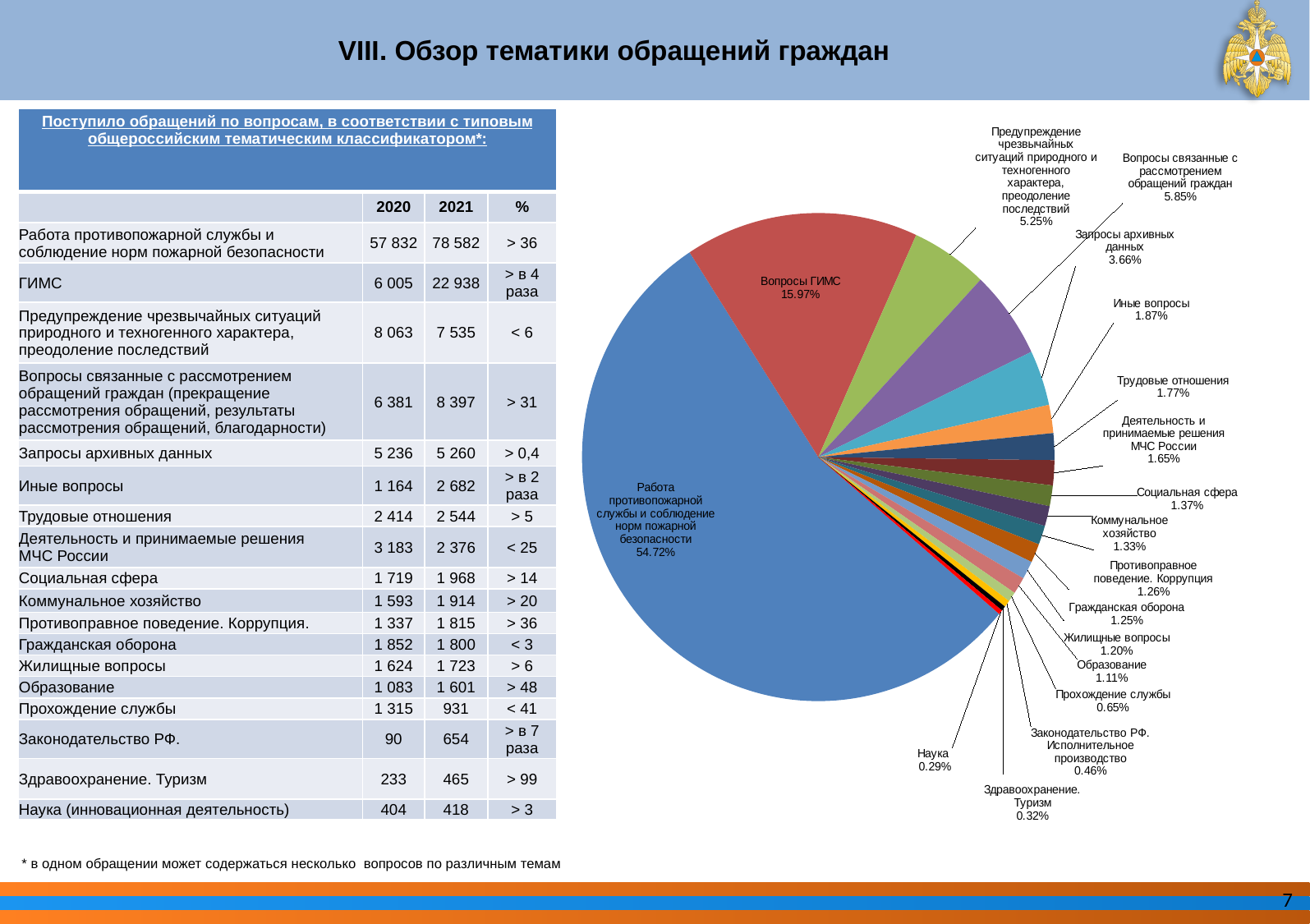
How many slices does the pie chart have? 18 Which slice of the pie chart is the largest? Работа противопожарной службы и соблюдение норм пожарной безопасности In the pie chart, what percentage is labelled for "Запросы архивных данных"? 3.66% What kind of chart is shown on the right side of the slide? pie chart In the pie chart, what share is shown for "Вопросы ГИМС"? 15.97% In the pie chart, what share is shown for "Работа противопожарной службы и соблюдение норм пожарной безопасности"? 54.72% In the pie chart, what percentage is labelled for "Здравоохранение. Туризм"? 0.32% Which slice of the pie chart is the smallest? Наука In the pie chart, what percentage is labelled for "Наука"? 0.29% In the pie chart, which is larger: "Предупреждение чрезвычайных ситуаций..." or "Вопросы связанные с рассмотрением обращений граждан"? Вопросы связанные с рассмотрением обращений граждан In the pie chart, what percentage is labelled for "Трудовые отношения"? 1.77% In the pie chart, what is the difference between the shares of "Вопросы ГИМС" and "Запросы архивных данных"? 12.31%